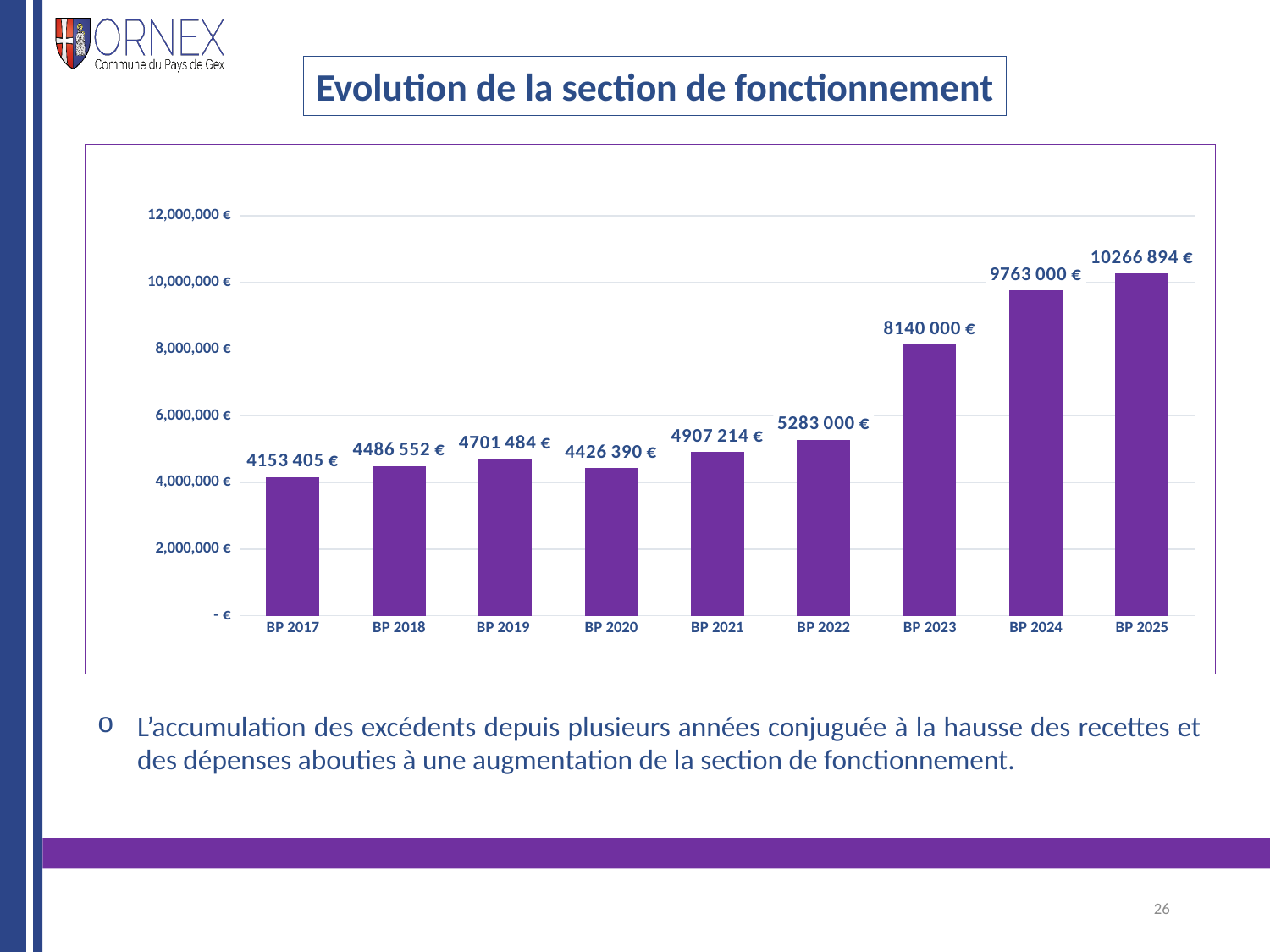
Is the value for BP 2022 greater or less than 4,000,000 €? greater Do the values generally rise or fall from BP 2017 to BP 2025? rise Which year has the lowest value? BP 2017 What is the difference between the values for BP 2023 and BP 2022? 2 857 000 € What is the value for BP 2017? 4 153 405 € Which is larger, the value for BP 2019 or BP 2020? BP 2019 How many years are shown on the x axis? 9 Which year has the highest value? BP 2025 What is the value for BP 2023? 8 140 000 € What kind of chart is shown on the slide? bar chart What is the value for BP 2025? 10 266 894 € What is the difference between the values for BP 2025 and BP 2024? 503 894 €